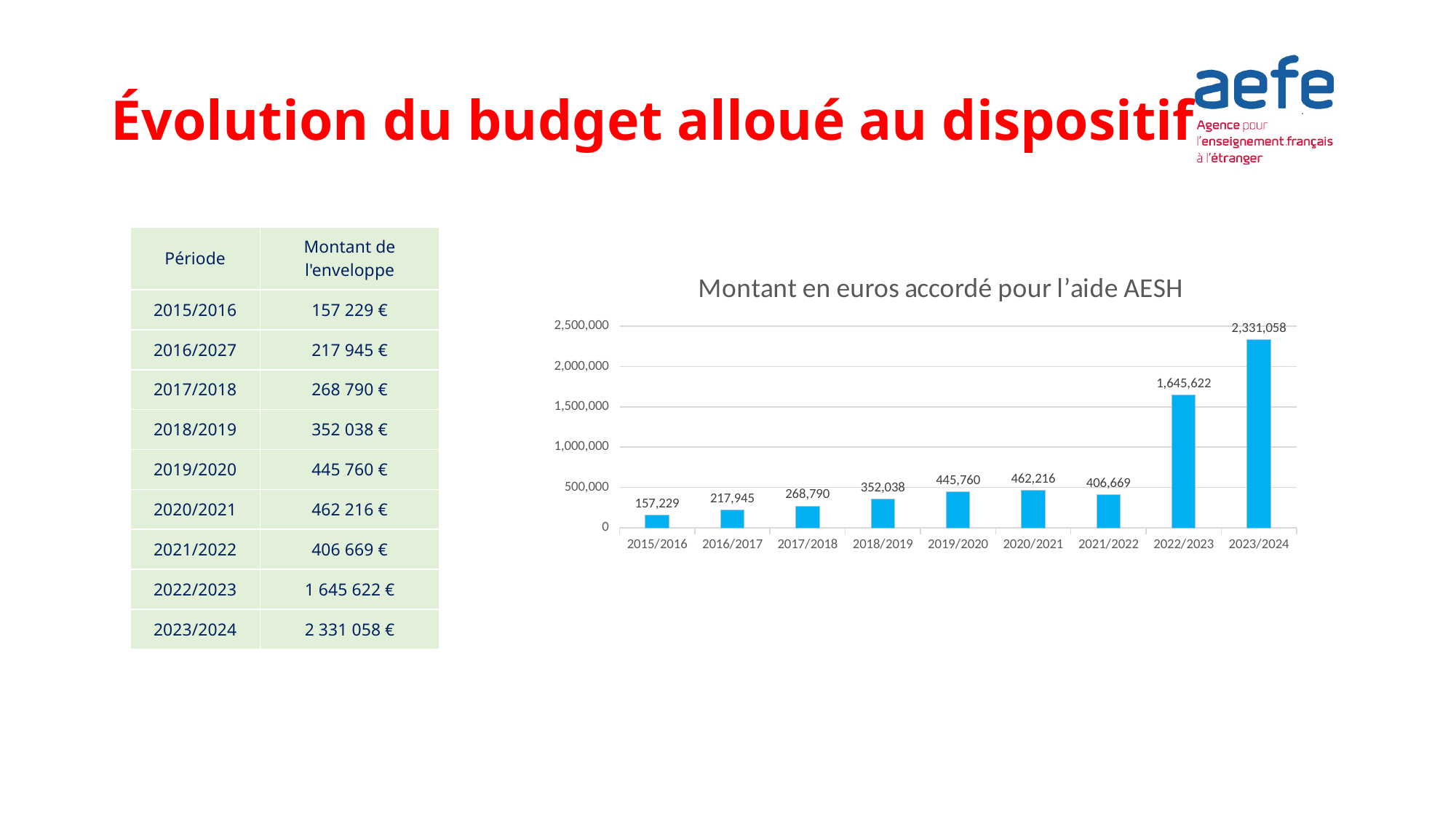
What is the value for 2022/2023 in the chart? 1,645,622 Which period has the lowest value in the chart? 2015/2016 Which is larger, the value for 2020/2021 or the value for 2021/2022? 2020/2021 What is the value for 2017/2018 in the chart? 268,790 What type of chart is shown on the slide? Bar chart What is the difference between the values for 2023/2024 and 2022/2023? 685,436 How many periods are shown on the x axis of the chart? 9 What is the title of the chart? Montant en euros accordé pour l'aide AESH Do the values generally rise or fall from 2015/2016 to 2023/2024? Rise Is the value for 2022/2023 greater or less than 1,500,000? greater What is the value for 2019/2020 in the chart? 445,760 Which period has the highest value in the chart? 2023/2024